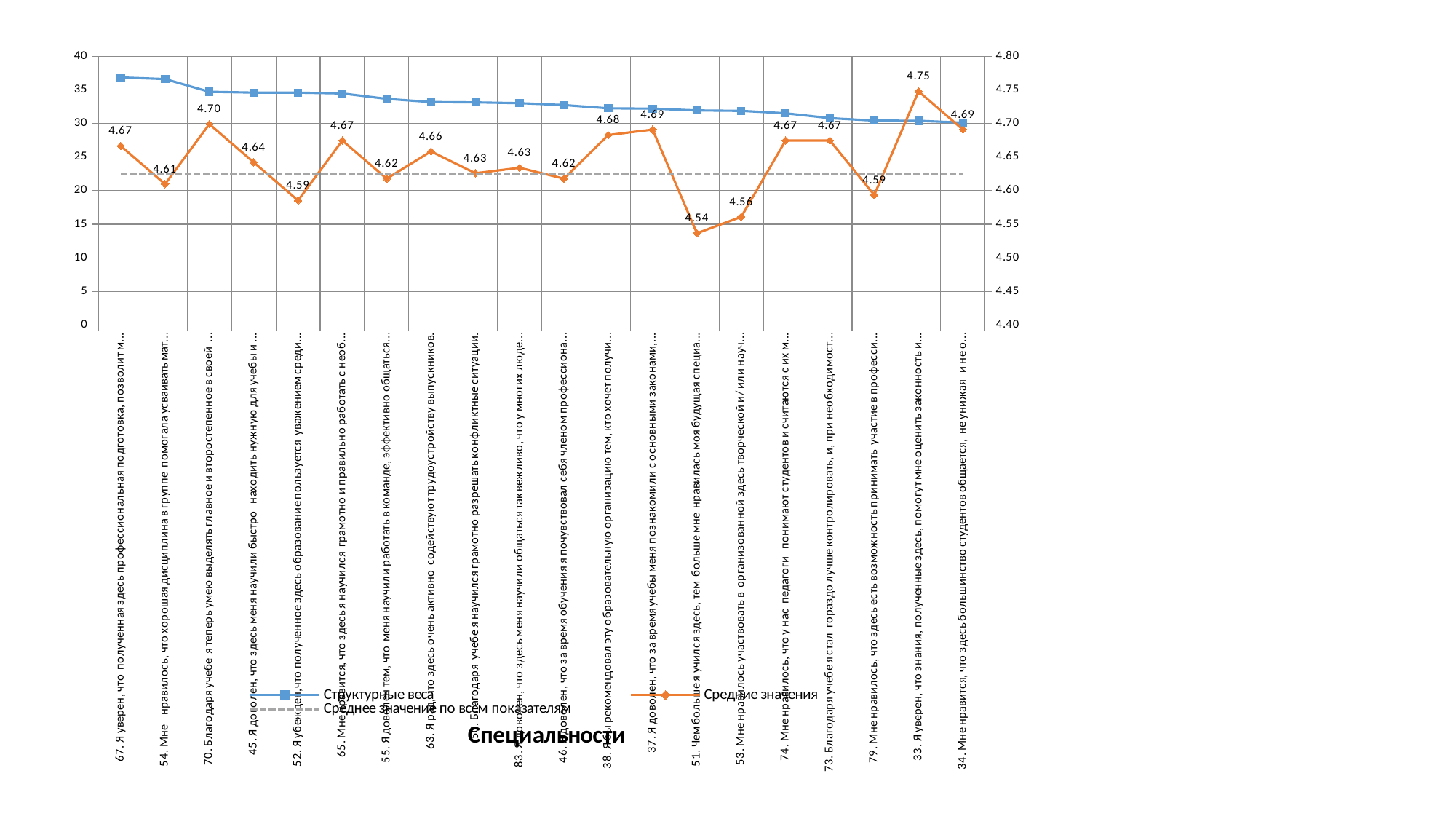
Which category has the lowest value in the 'Средние значения' series? 51. Чем больше я учился здесь, тем больше мне нравилась моя будущая специа... Is the value of the 'Структурные веса' series for the first category (beginning '67. Я уверен, что полученная здесь профессиональная подготовка...') greater or less than 35? greater In the 'Средние значения' series, which is larger: the value for the category beginning '54. Мне нравилось, что хорошая дисциплина...' or the category beginning '45. Я доволен, что здесь меня научили быстро...'? 45. Я доволен, что здесь меня научили быстро находить нужную для учебы и... How many categories are plotted along the x axis? 20 What is the title of the x axis? Специальности What kind of chart is shown on the slide? line chart What is the difference between the highest and lowest values of the 'Средние значения' series? 0.21 What is the value of the 'Средние значения' series for the category beginning '33. Я уверен, что знания, полученные здесь...'? 4.75 How many series does the legend list? 3 What is the value of the 'Средние значения' series for the category beginning '51. Чем больше я учился здесь...'? 4.54 What is the value of the 'Средние значения' series for the category beginning '70. Благодаря учебе я теперь умею выделять главное...'? 4.70 Which category has the highest value in the 'Средние значения' series? 33. Я уверен, что знания, полученные здесь, помогут мне оценить законность и...